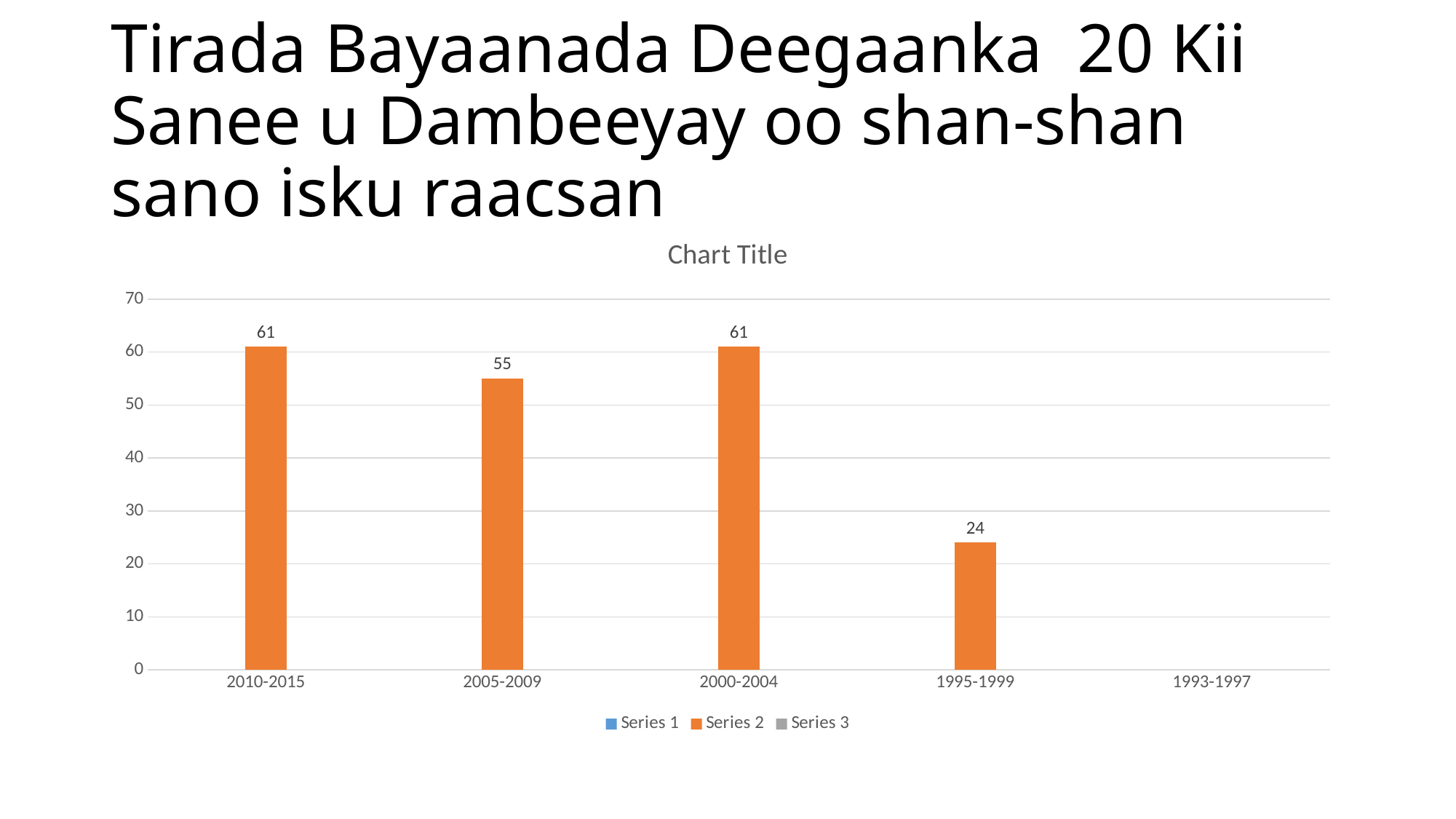
What is the value for 1995-1999? 24 Among the categories with a visible bar, which has the lowest value? 1995-1999 What is the value for 2010-2015? 61 How many categories are shown on the x axis? 5 Which is larger, the value for 2005-2009 or the value for 1995-1999? 2005-2009 How many series does the legend list? 3 What is the difference between the values for 2010-2015 and 2005-2009? 6 What is the value for 2000-2004? 61 What is the value for 2005-2009? 55 What is the difference between the values for 2005-2009 and 1995-1999? 31 What kind of chart is shown on the slide? bar chart Is the value for 1995-1999 greater or less than 30? less